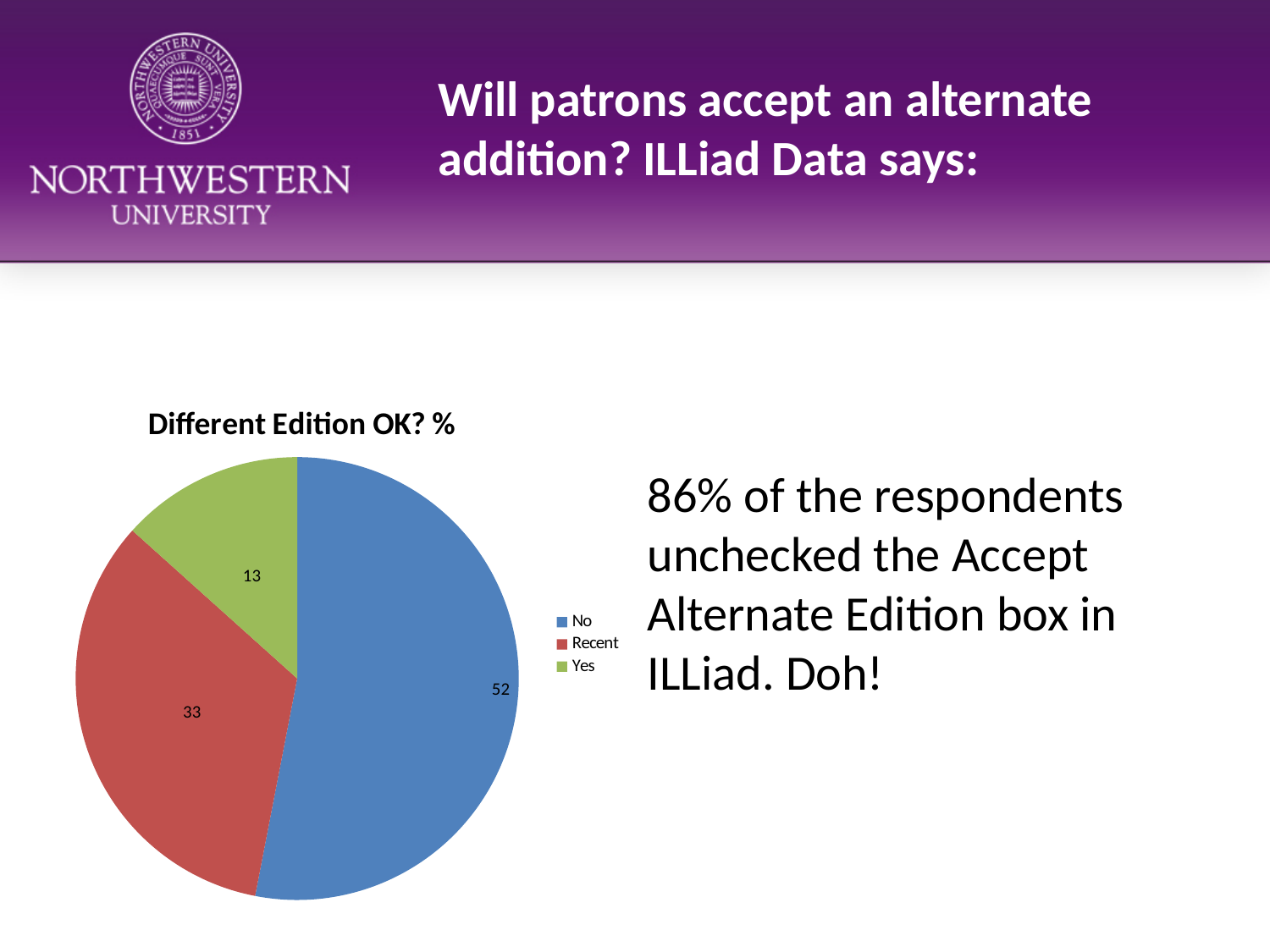
Which category has the largest slice? No What is the value for the Recent slice? 33 What is the value for the No slice? 52 What colour is the No slice? blue What is the difference between the No and Recent values? 19 Which category has the smallest slice? Yes What is the title of the chart? Different Edition OK? % Which is larger, the Recent slice or the Yes slice? Recent What is the value for the Yes slice? 13 How many categories does the legend list? 3 What is the difference between the Recent and Yes values? 20 What type of chart is shown on the slide? pie chart